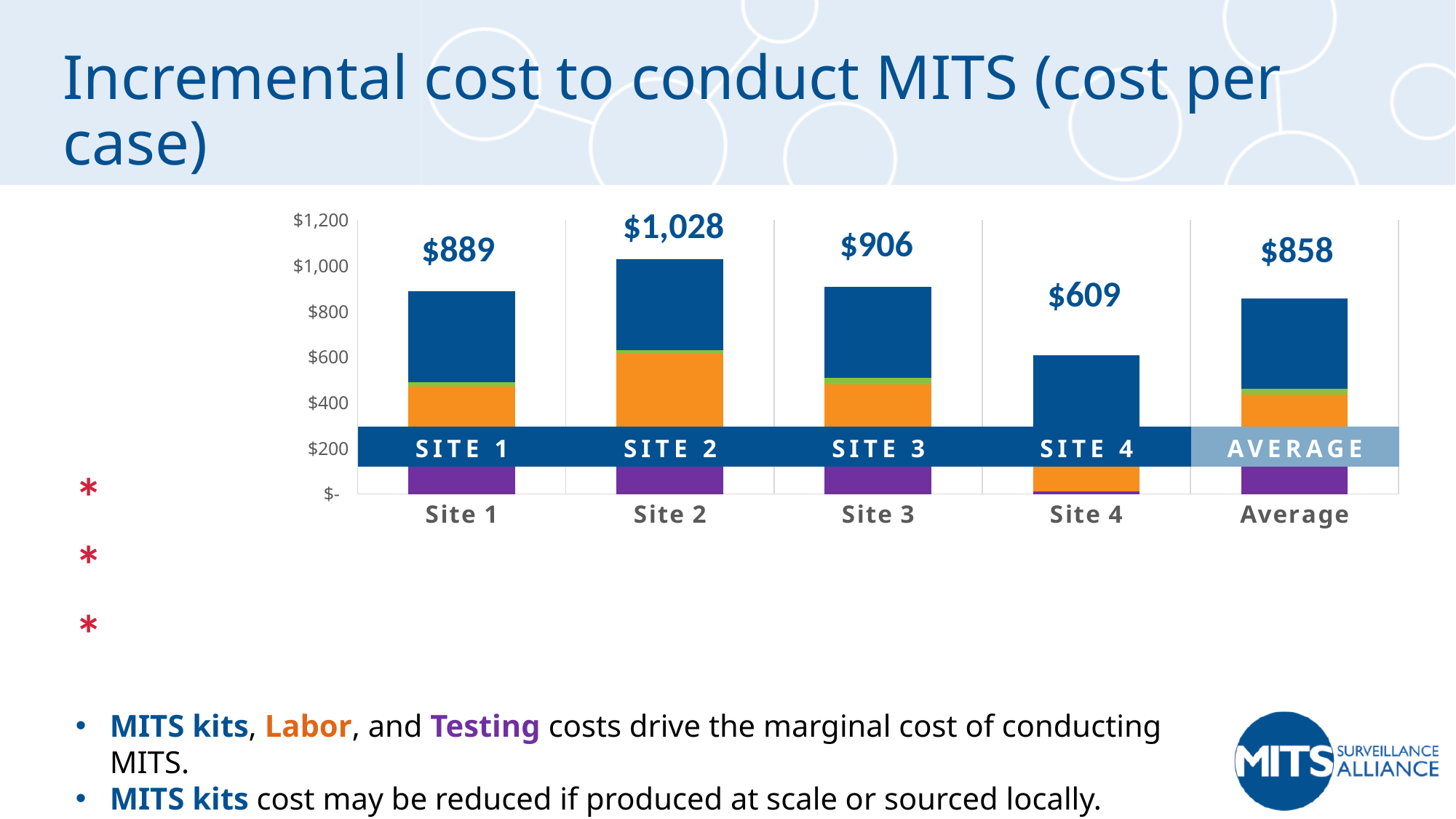
What is the difference between the total cost per case for Site 3 and Site 1? $17 Which site has the highest total incremental cost per case? Site 2 What is the title of the slide containing the chart? Incremental cost to conduct MITS (cost per case) Which site has the lowest total incremental cost per case? Site 4 Which has a higher total cost per case, Site 1 or Site 3? Site 3 How many categories (bars) are shown on the chart? 5 Is the total cost per case for Site 4 greater or less than $800? less What is the average incremental cost per case shown on the chart? $858 What is the difference between the total cost per case for Site 2 and Site 4? $419 What kind of chart is shown on the slide? Stacked bar chart What is the total incremental cost per case for Site 2? $1,028 What is the total incremental cost per case for Site 4? $609